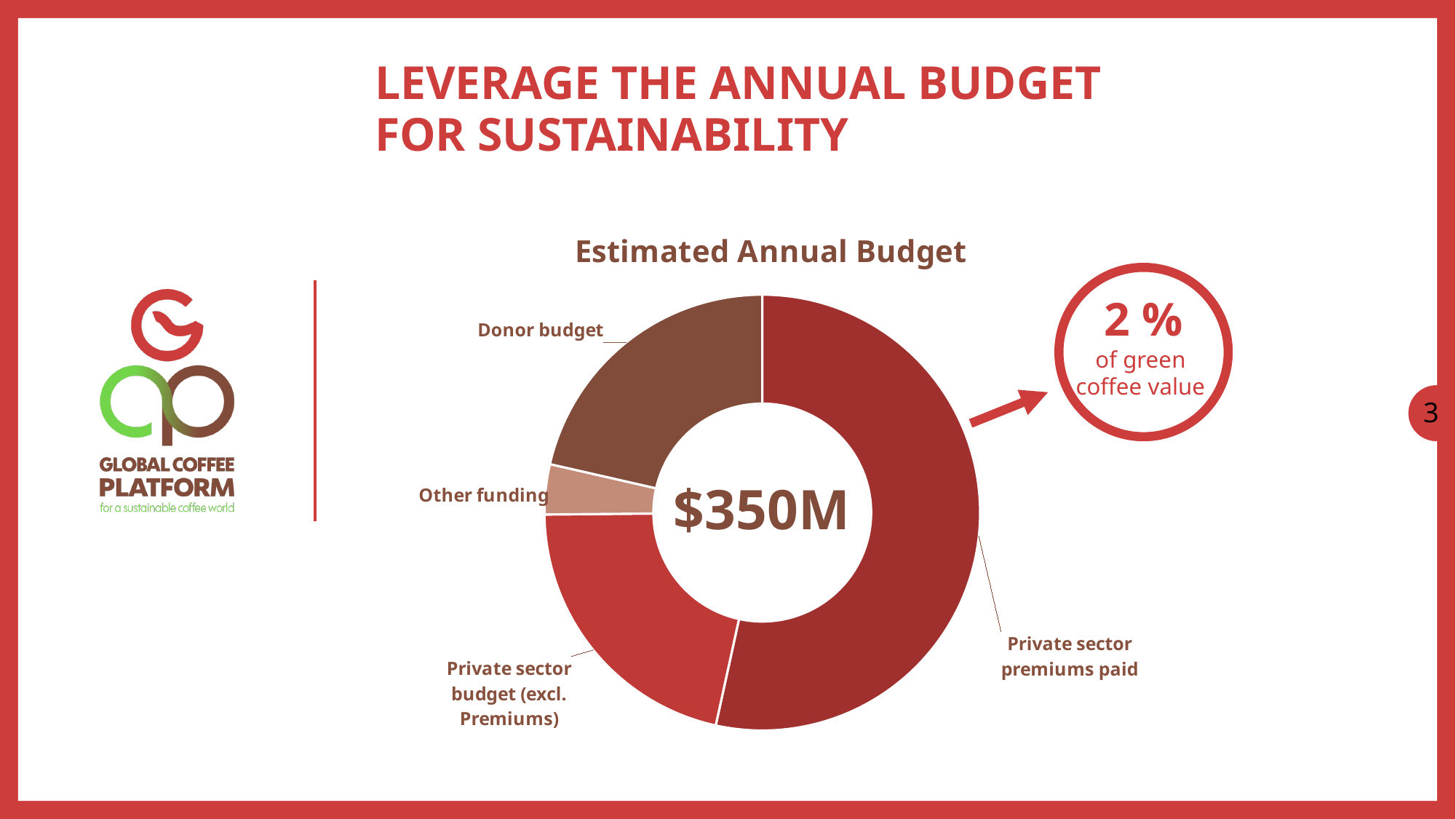
What total value is printed in the centre of the donut chart? $350M What kind of chart is shown on the slide? Pie (donut) chart Which slice is larger: Private sector premiums paid or Private sector budget (excl. Premiums)? Private sector premiums paid Which slice is larger: Donor budget or Other funding? Donor budget What is the title of the chart? Estimated Annual Budget Which slice is larger: Private sector premiums paid or Donor budget? Private sector premiums paid Which category has the largest slice of the chart? Private sector premiums paid What percentage of green coffee value does the annotation next to the chart state? 2 % How many categories (slices) does the chart have? 4 Which category has the smallest slice of the chart? Other funding